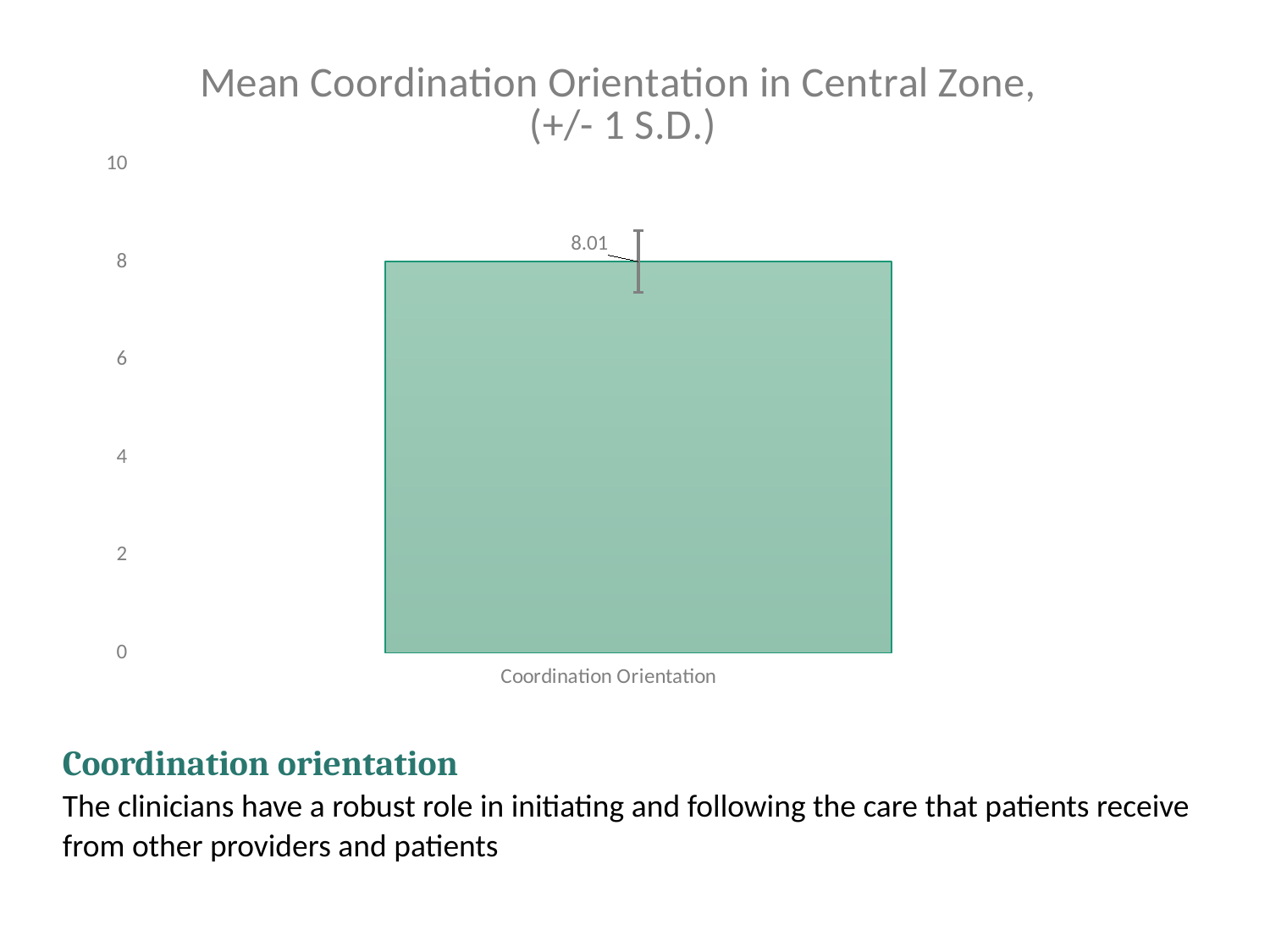
Is the value for Coordination Orientation greater or less than 10? less What is the category label shown on the x axis? Coordination Orientation Is the value for Coordination Orientation greater or less than 6? greater What is the title of the chart? Mean Coordination Orientation in Central Zone, (+/- 1 S.D.) What is the maximum value shown on the y axis? 10 What is the value shown for Coordination Orientation? 8.01 What kind of chart is shown on the slide? bar chart How many bars are plotted in the chart? 1